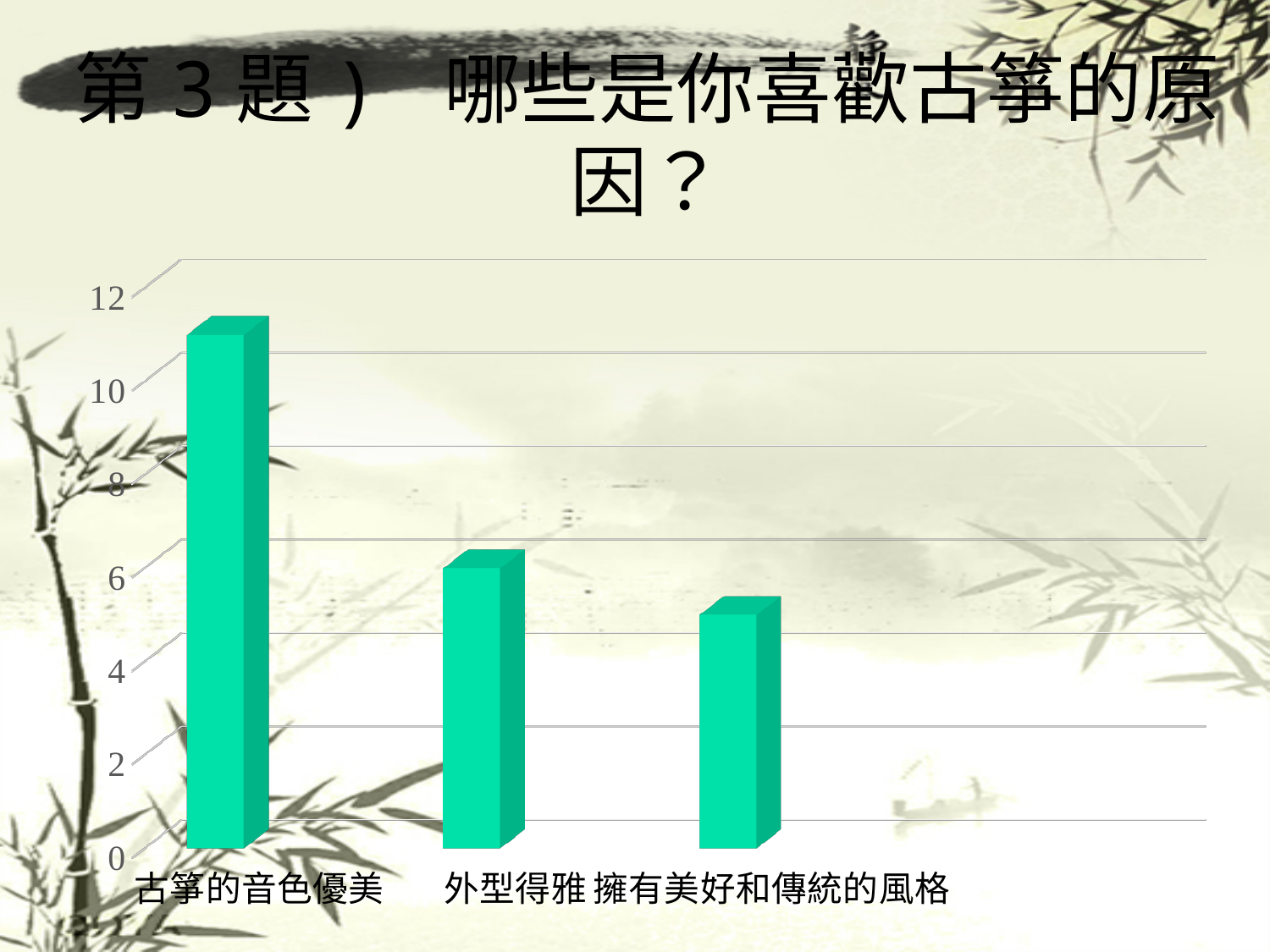
Is the value for 外型得雅 greater or less than 8? less Is the value for 擁有美好和傳統的風格 greater or less than 4? greater What is the highest value shown on the vertical axis? 12 How many categories are shown in the chart? 3 What kind of chart is shown on the slide? bar chart Which is larger, the value for 古箏的音色優美 or the value for 外型得雅? 古箏的音色優美 Do the values rise or fall from left to right across the categories? fall Is the value for 古箏的音色優美 greater or less than 10? greater Which category has the highest value? 古箏的音色優美 Which category has the lowest value? 擁有美好和傳統的風格 What is the title of the slide containing the chart? 第３題） 哪些是你喜歡古箏的原因？